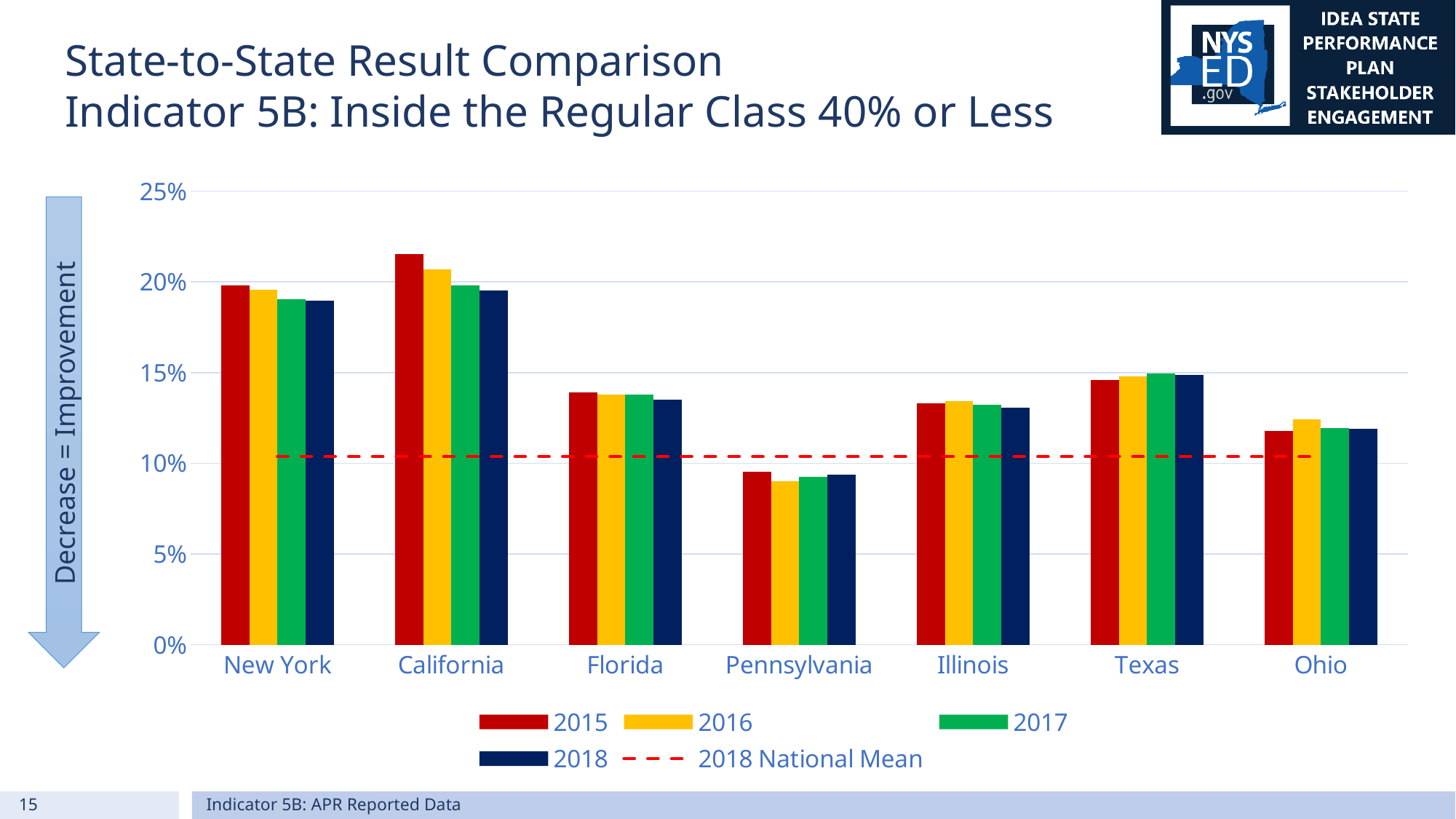
Which is larger, the 2015 value for Texas or the 2015 value for Florida? Texas What does the dashed red line on the chart represent? 2018 National Mean What kind of chart is shown on the slide? Bar chart Is the 2015 value for California greater or less than 20%? greater Which state has the highest 2015 value? California How many states are shown on the x axis of the chart? 7 How many entries does the chart's legend list? 5 Which state has the lowest 2015 value? Pennsylvania Which is larger, the 2018 value for New York or the 2018 value for Texas? New York Is the 2016 value for Pennsylvania greater or less than 10%? less Do California's values rise or fall from 2015 to 2018? fall Is the 2016 value for Ohio greater or less than 15%? less